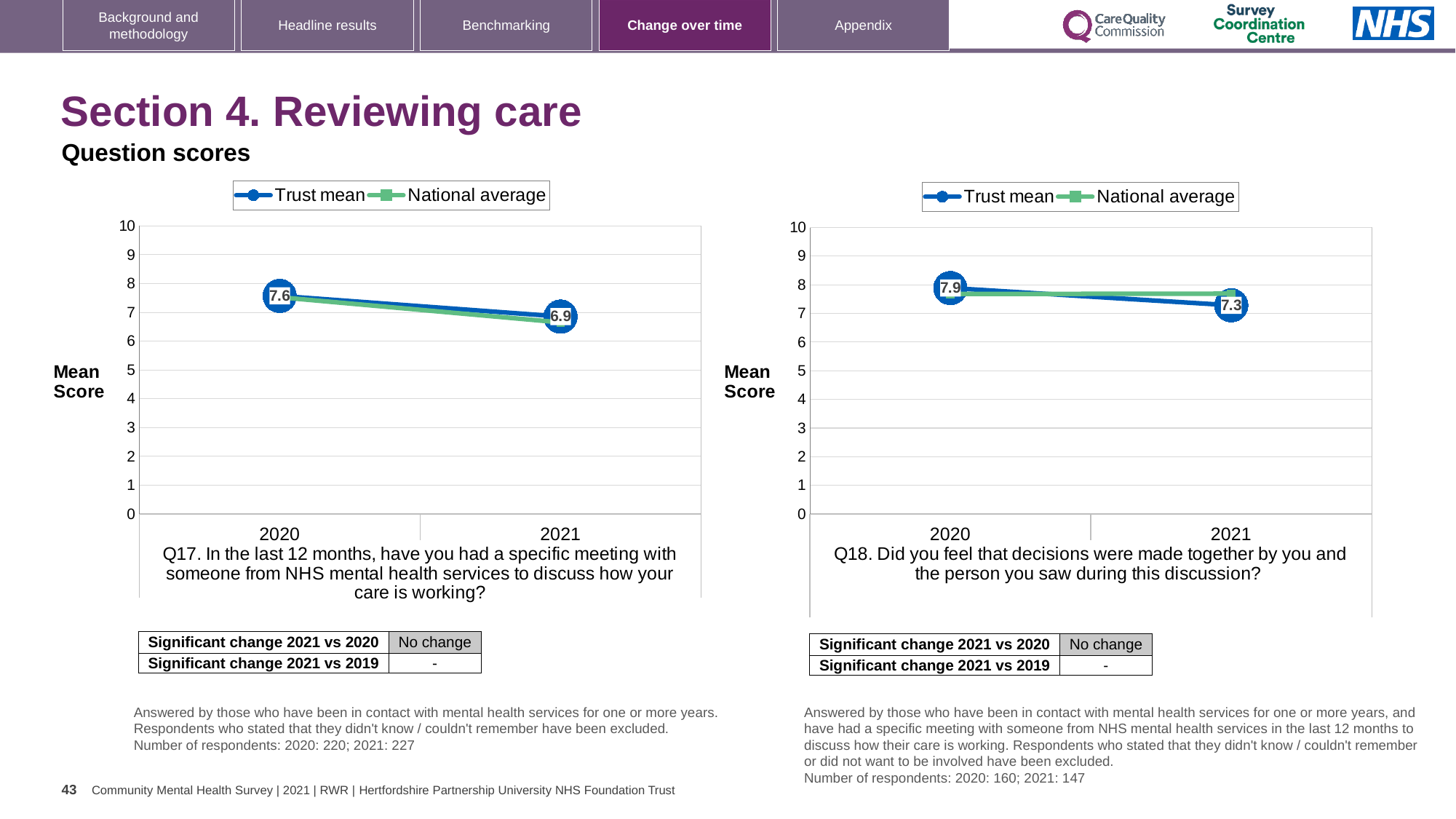
In the Q18 chart on the right, does the Trust mean rise or fall from 2020 to 2021? fall In the Q17 chart on the left, is the National average for 2021 greater or less than 5? greater In the Q17 chart on the left, what is the Trust mean for 2021? 6.9 What type of chart is the Q17 chart on the left? line chart How many years are shown on the x axis of the Q17 chart on the left? 2 In the Q18 chart on the right, what is the Trust mean for 2020? 7.9 In the Q18 chart on the right, what is the difference between the Trust mean in 2020 and in 2021? 0.6 How many series does the legend of the Q18 chart on the right list? 2 In the Q18 chart on the right, what is the Trust mean for 2021? 7.3 In the Q17 chart on the left, by how much did the Trust mean change from 2020 to 2021? 0.7 In the Q17 chart on the left, what is the Trust mean for 2020? 7.6 Which chart has the higher Trust mean for 2020, the Q17 chart on the left or the Q18 chart on the right? Q18 chart on the right